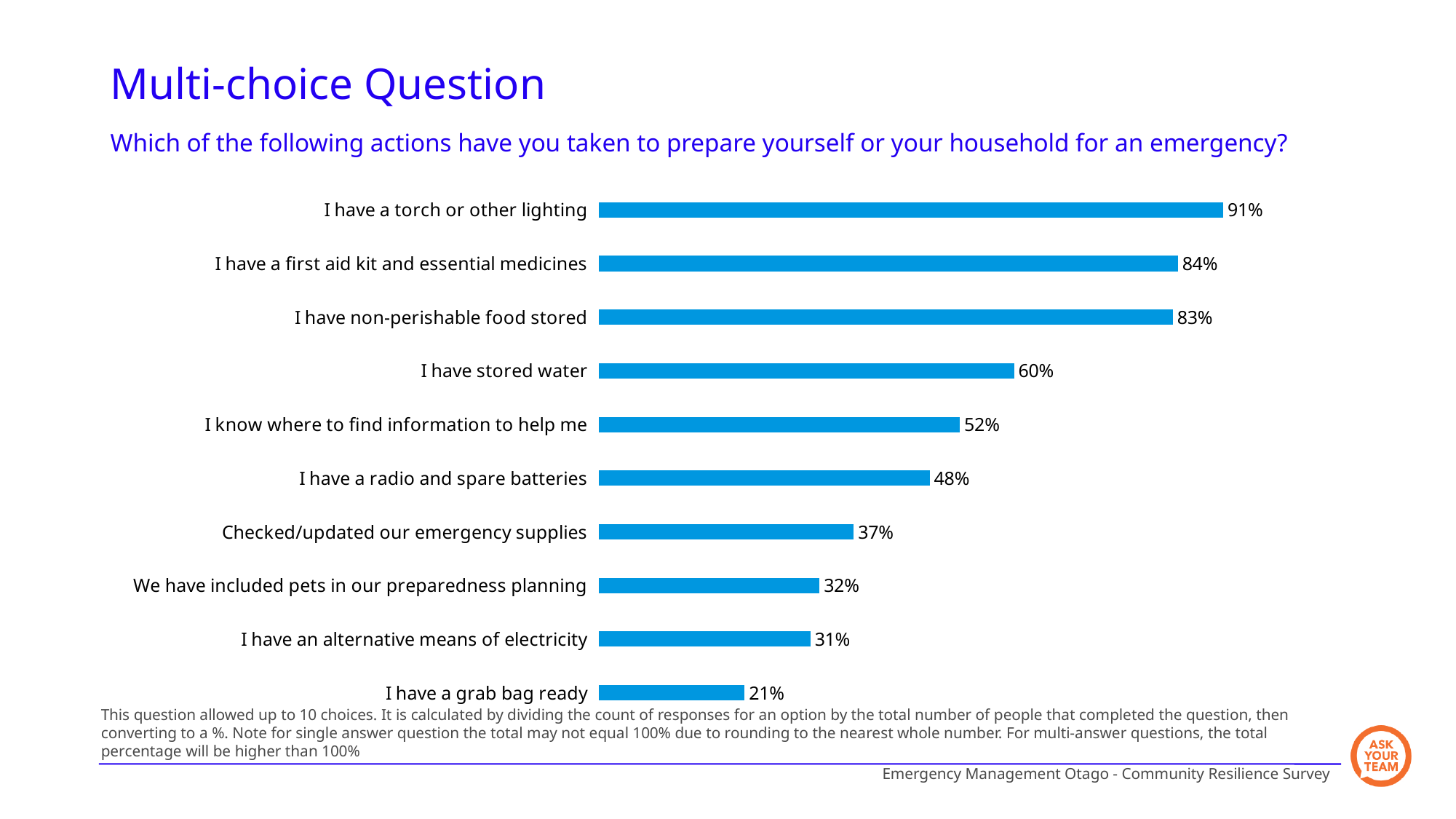
What is the difference in percentage points between 'I have a first aid kit and essential medicines' and 'I have a radio and spare batteries'? 36 What percentage of respondents said they have included pets in their preparedness planning? 32% How many actions (categories) are shown in the chart? 10 Which action has the lowest percentage of respondents? I have a grab bag ready What type of chart is shown on the slide? Bar chart What is the difference in percentage points between 'Checked/updated our emergency supplies' and 'I have an alternative means of electricity'? 6 What percentage of respondents said they have a grab bag ready? 21% What percentage of respondents said they have a torch or other lighting? 91% Which action has the highest percentage of respondents? I have a torch or other lighting What survey question does the chart answer? Which of the following actions have you taken to prepare yourself or your household for an emergency? What percentage of respondents said they have stored water? 60% Which has a higher percentage: 'I have stored water' or 'I know where to find information to help me'? I have stored water